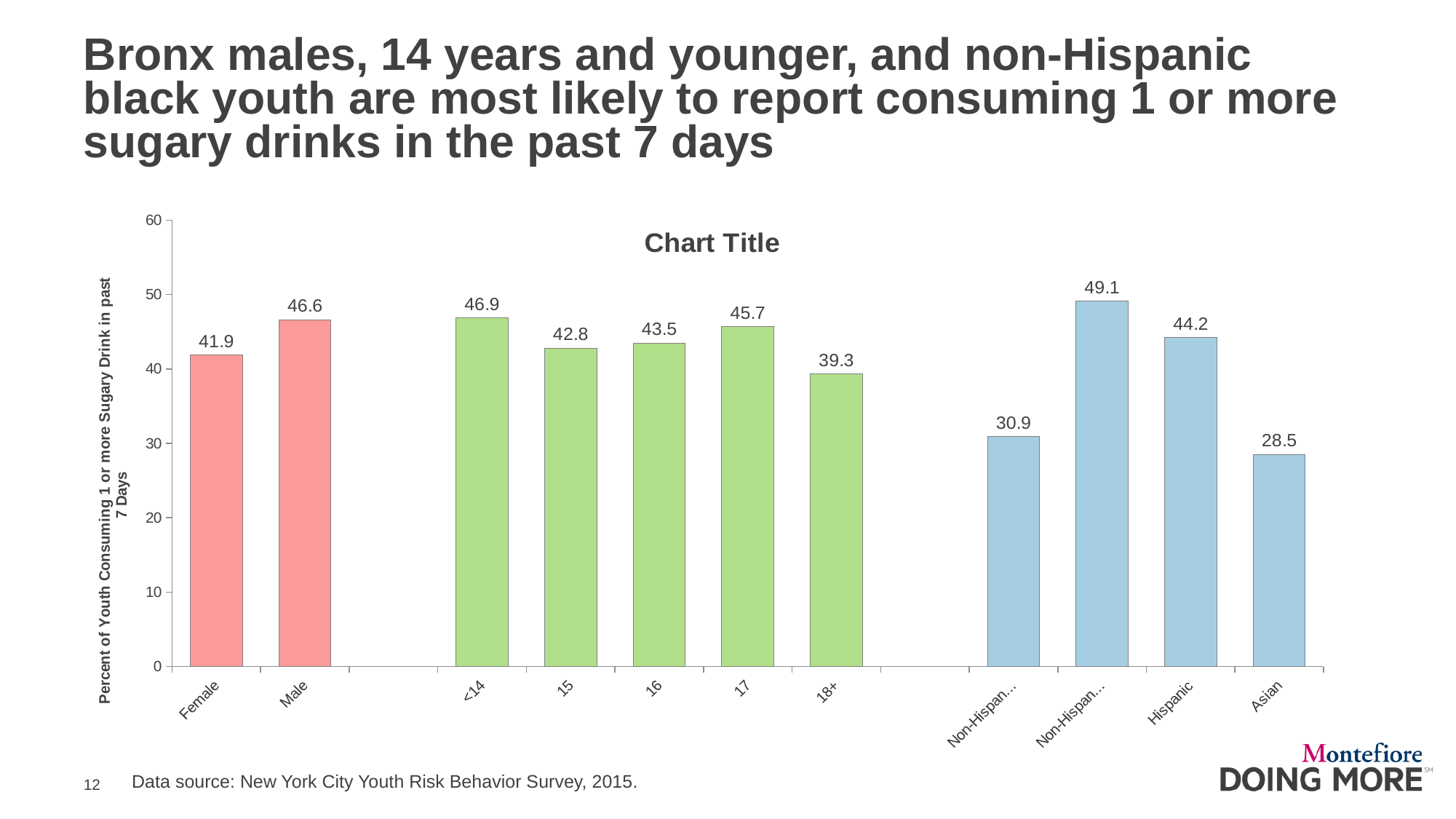
What is the value for the 18+ age group? 39.3 What is the value for Male? 46.6 Is the value for Asian greater or less than 30? less What is the value for the <14 age group? 46.9 What is the difference between the values for Male and Female? 4.7 Among the age groups (<14, 15, 16, 17, 18+), which has the highest value? <14 How many bars are plotted in the chart? 11 Which is larger, the value for 17 or the value for 16? 17 What type of chart is shown on the slide? Bar chart What is the value for Hispanic? 44.2 What is the value for Female? 41.9 Which category has the lowest value? Asian